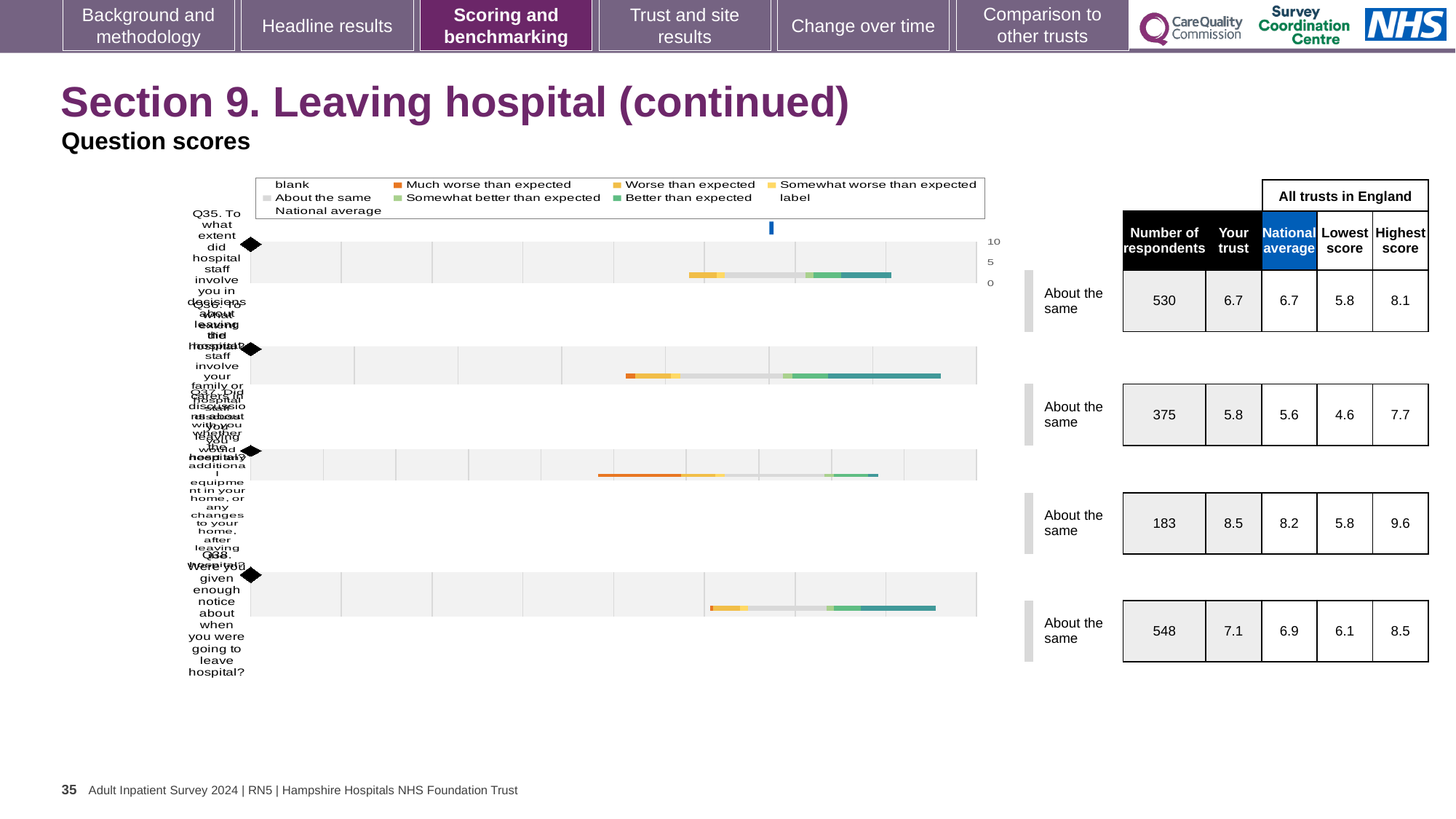
In the table beside the chart, what is the 'Your trust' score for the first row (Q35)? 6.7 What kind of chart is shown on the slide? bar chart In the table beside the chart, what is the difference between the 'Your trust' score and the 'National average' for the third row? 0.3 In the table beside the chart, what is the 'Your trust' score for the last row (Q38)? 7.1 What benchmark category is shown next to the last bar (Q38) in the chart? About the same In the table beside the chart, what is the number of respondents for the last row (Q38)? 548 In the table beside the chart, which row has the lowest 'Your trust' score? the second row (5.8) How many question bars are plotted in the chart? 4 Which legend entry is shown in dark teal in the chart's legend? Better than expected In the table beside the chart, which row has the highest 'Your trust' score? the third row (8.5) What benchmark category is shown next to the first bar (Q35) in the chart? About the same Which legend entry is shown in orange in the chart's legend? Much worse than expected